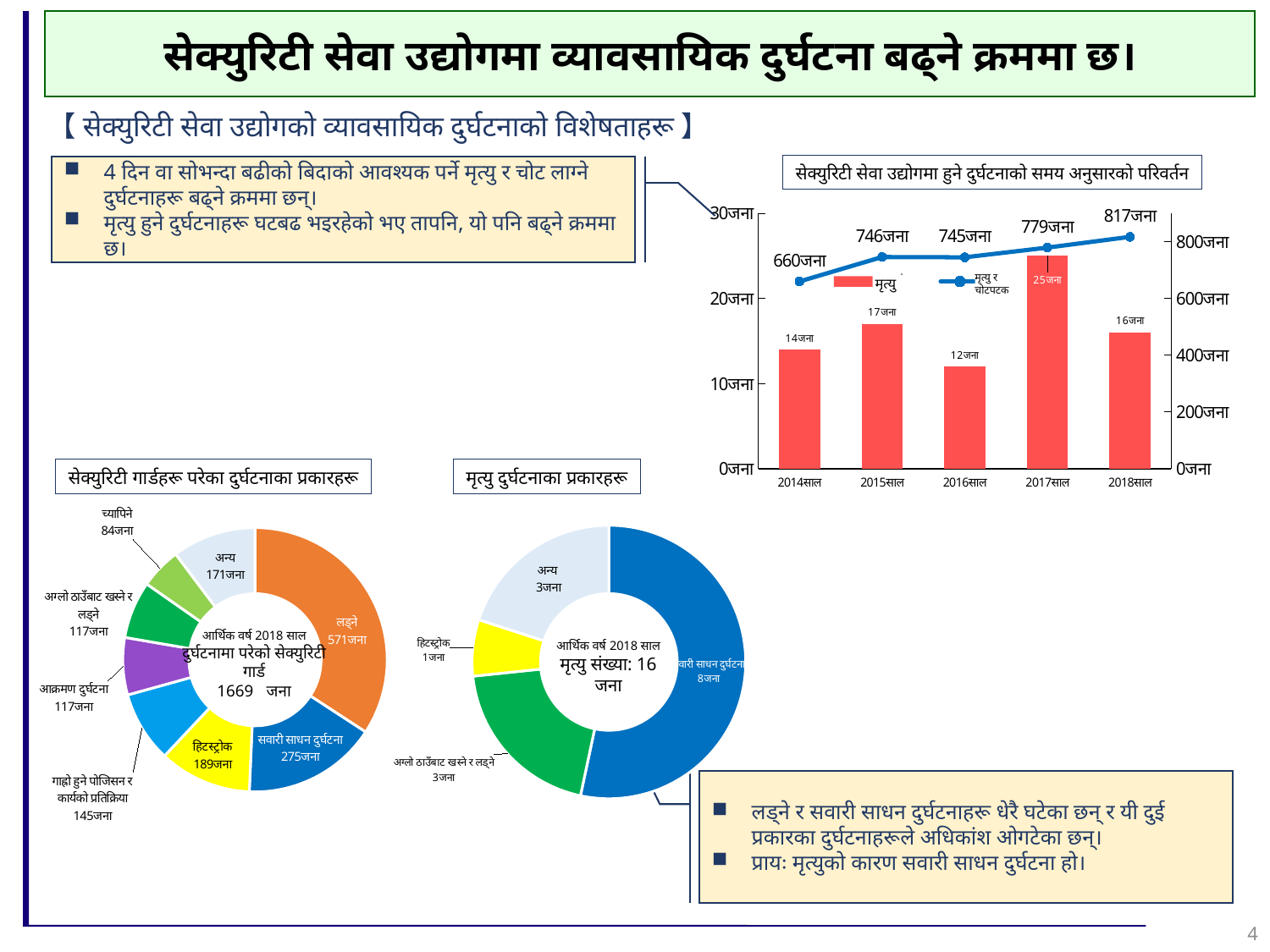
In the chart titled 'सेक्युरिटी गार्डहरू परेका दुर्घटनाका प्रकारहरू' (bottom left), what is the value for लड्ने? 571जना In the chart titled 'सेक्युरिटी सेवा उद्योगमा हुने दुर्घटनाको समय अनुसारको परिवर्तन' (top right), what is the value of the मृत्यु bar for 2017साल? 25जना In the bottom-left chart 'सेक्युरिटी गार्डहरू परेका दुर्घटनाका प्रकारहरू', which is larger: हिटस्ट्रोक or सवारी साधन दुर्घटना? सवारी साधन दुर्घटना In the chart titled 'मृत्यु दुर्घटनाका प्रकारहरू' (bottom middle), what is the value for सवारी साधन दुर्घटना? 8जना In the top-right chart, what is the value of the मृत्यु र चोटपटक line for 2018साल? 817जना In the bottom-left chart 'सेक्युरिटी गार्डहरू परेका दुर्घटनाका प्रकारहरू', which category is the largest? लड्ने In the top-right chart, what is the difference between the मृत्यु र चोटपटक values for 2018साल and 2014साल? 157जना What kind of chart is the 'मृत्यु दुर्घटनाका प्रकारहरू' chart? Donut (pie) chart In the top-right chart, which year has the highest मृत्यु र चोटपटक value? 2018साल In the top-right chart, how many series does the legend list? 2 In the top-right chart, which year has the lowest मृत्यु bar? 2016साल In the top-right chart, does the मृत्यु र चोटपटक line generally rise or fall from 2014साल to 2018साल? rise